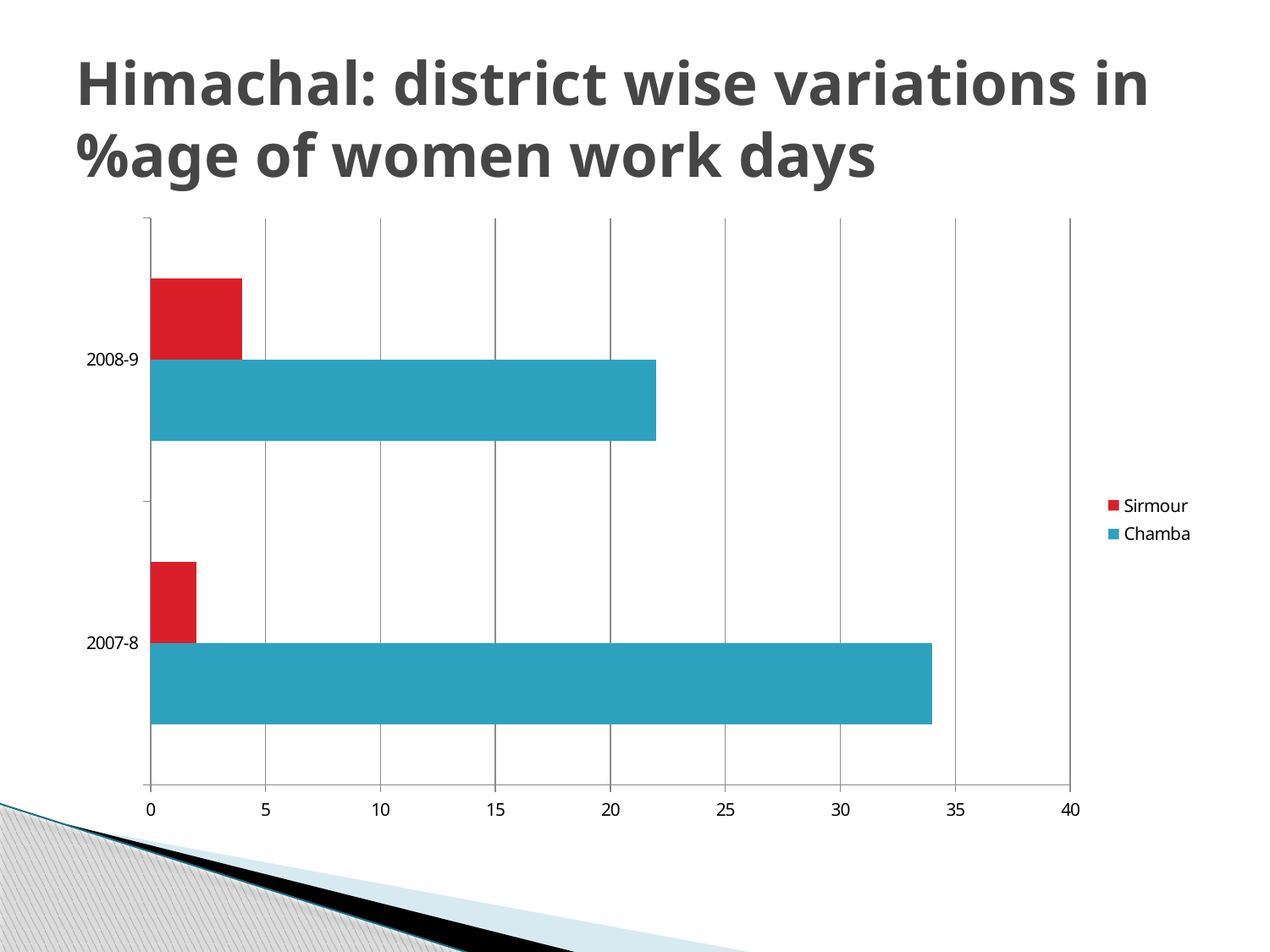
Is the value for Chamba in 2007-8 greater or less than 30? greater Which year has the lowest Sirmour value? 2007-8 How many year categories are shown on the vertical axis? 2 How many series does the legend list? 2 Is the value for Sirmour in 2007-8 greater or less than 5? less Which series does the red colour represent in the legend? Sirmour Which is larger, the Chamba value for 2007-8 or the Chamba value for 2008-9? 2007-8 Is the value for Chamba in 2008-9 greater or less than 25? less What kind of chart is shown on the slide? bar chart Which series has the longest bar on the chart? Chamba What is the title of the chart on the slide? Himachal: district wise variations in %age of women work days